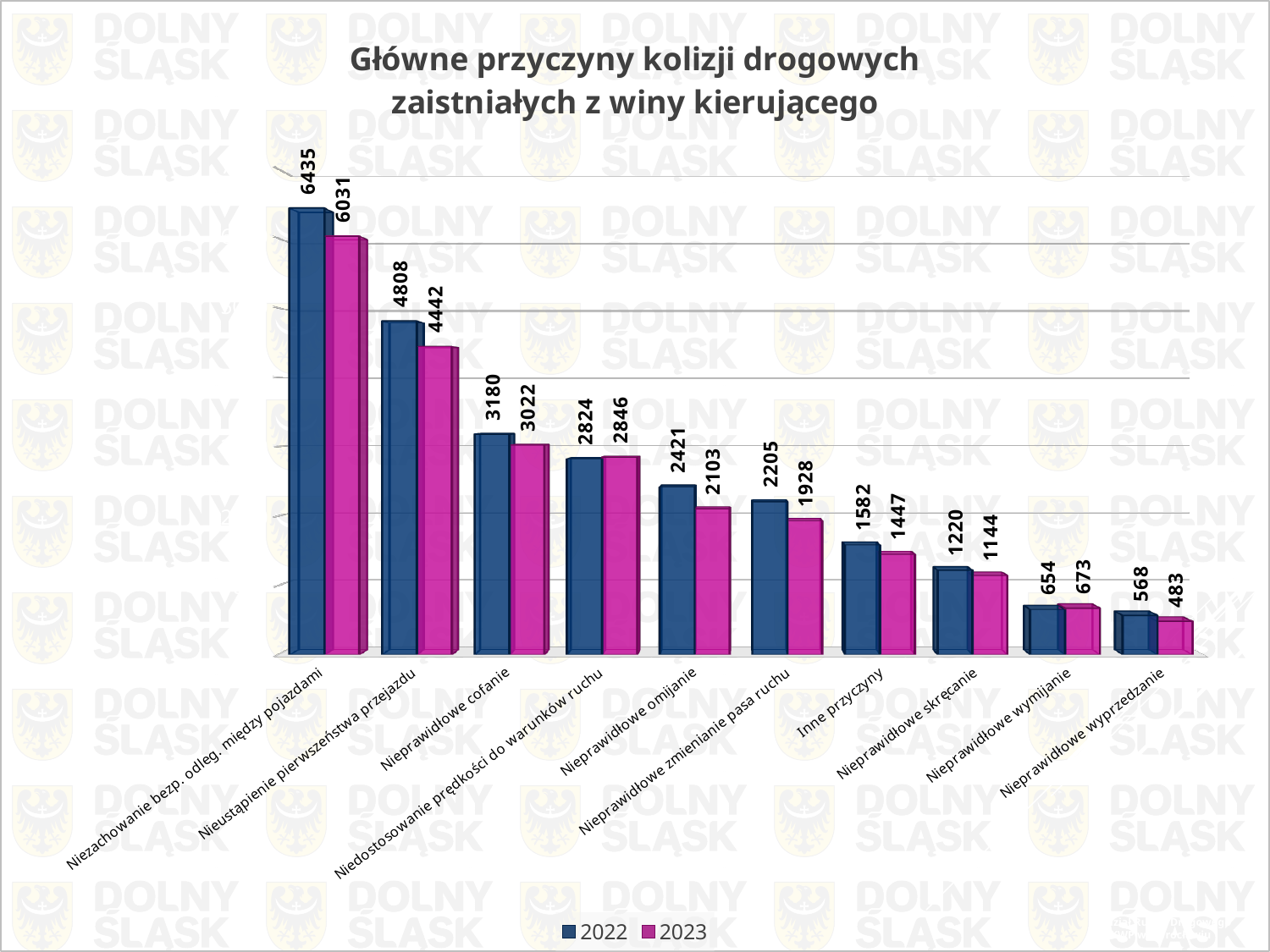
What is the title of the chart? Główne przyczyny kolizji drogowych zaistniałych z winy kierującego Do the 2022 values rise or fall moving from left to right along the x axis? fall What is the 2023 value for "Nieprawidłowe wymijanie"? 673 What is the 2023 value for "Inne przyczyny"? 1447 How many categories are shown on the x axis? 10 Which category has the lowest 2023 value? Nieprawidłowe wyprzedzanie How many series does the legend list? 2 Which category has the highest 2022 value? Niezachowanie bezp. odleg. między pojazdami What is the 2022 value for "Nieprawidłowe cofanie"? 3180 What kind of chart is shown on the slide? bar chart Which is larger for "Niedostosowanie prędkości do warunków ruchu": the 2022 value or the 2023 value? 2023 What is the difference between the 2022 and 2023 values for "Nieustąpienie pierwszeństwa przejazdu"? 366